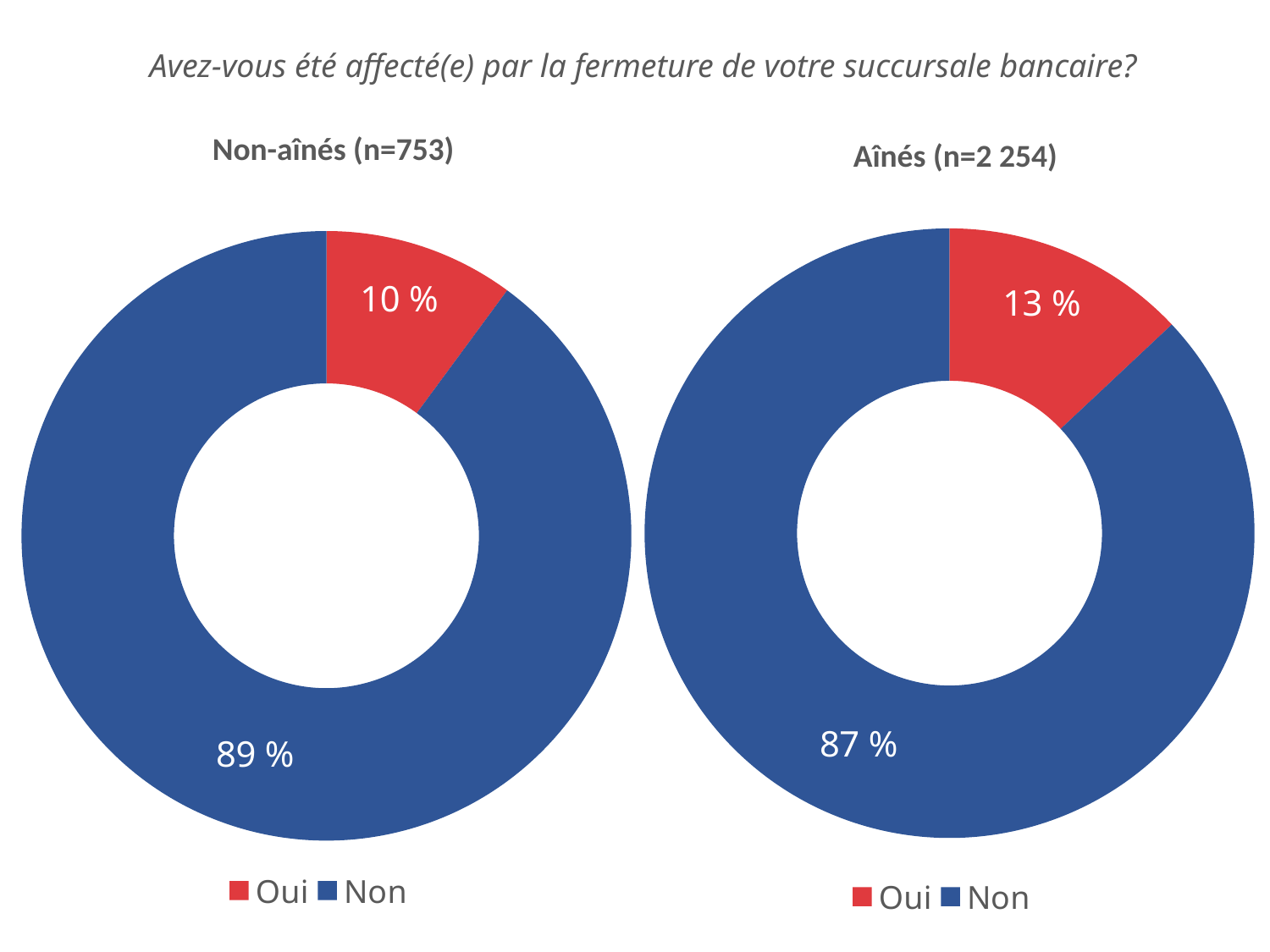
What kind of chart is the 'Non-aînés (n=753)' chart? Doughnut chart In the 'Aînés (n=2 254)' chart, which response has the largest share? Non In the 'Aînés (n=2 254)' chart, what percentage answered 'Non'? 87 % In the 'Non-aînés (n=753)' chart, what colour represents 'Oui'? Red How many categories does the legend of the 'Aînés (n=2 254)' chart list? 2 What is the difference between the 'Non' share in the 'Non-aînés (n=753)' chart and the 'Non' share in the 'Aînés (n=2 254)' chart? 2 % In the 'Non-aînés (n=753)' chart, which response has the smallest share? Oui What is the difference between the 'Oui' share in the 'Aînés (n=2 254)' chart and the 'Oui' share in the 'Non-aînés (n=753)' chart? 3 % In the 'Aînés (n=2 254)' chart, what percentage answered 'Oui'? 13 % Which chart shows a larger 'Oui' share, 'Non-aînés (n=753)' or 'Aînés (n=2 254)'? Aînés (n=2 254) In the 'Non-aînés (n=753)' chart, what percentage answered 'Oui'? 10 % In the 'Non-aînés (n=753)' chart, what percentage answered 'Non'? 89 %